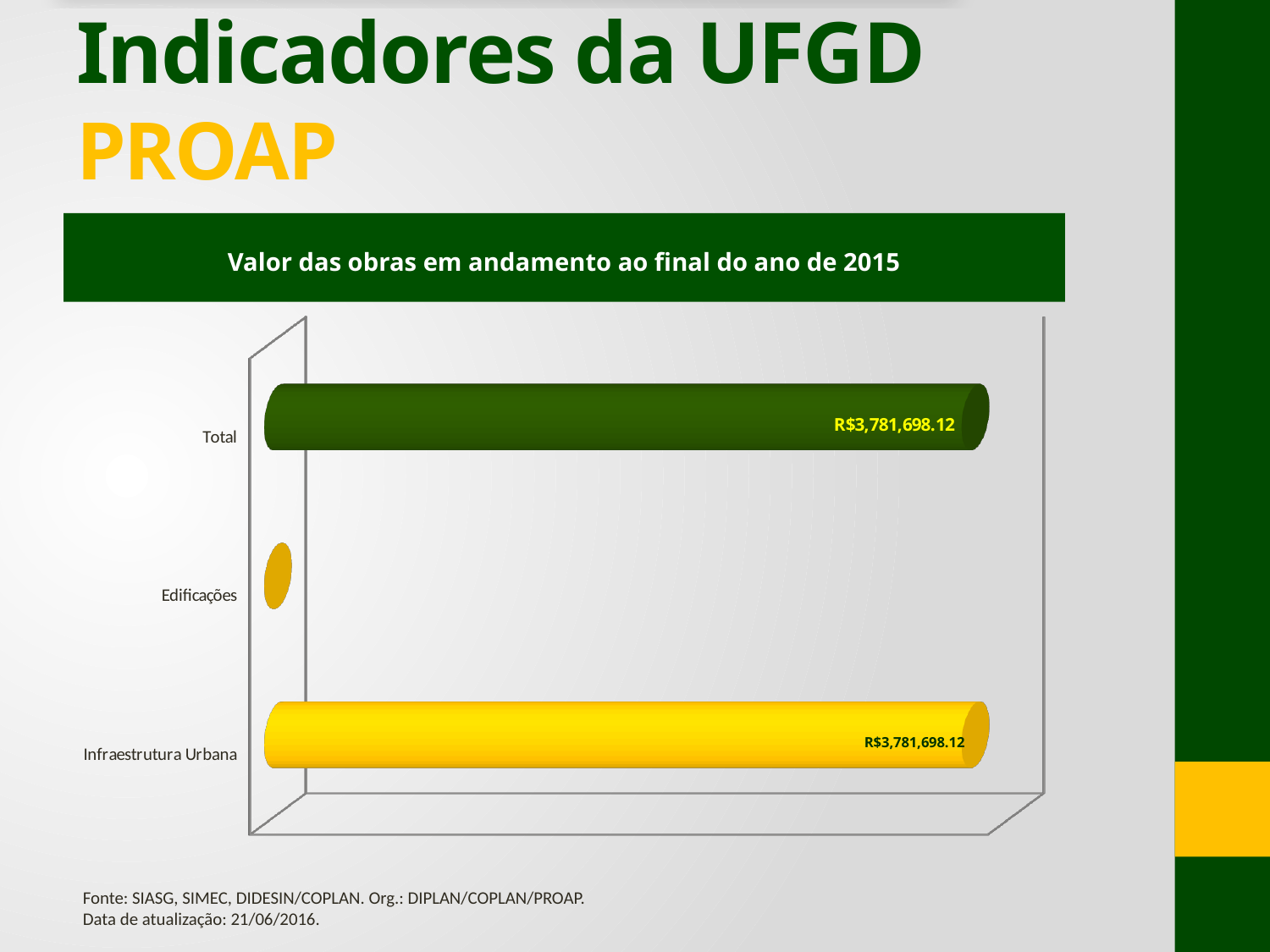
What is the value shown for Infraestrutura Urbana? R$3,781,698.12 What is the value shown for Total? R$3,781,698.12 Which category's bar is shown in dark green? Total Which is larger, the value for Total or the value for Edificações? Total What is the title of the chart? Valor das obras em andamento ao final do ano de 2015 Which is larger, the value for Infraestrutura Urbana or the value for Edificações? Infraestrutura Urbana What is the difference between the value for Total and the value for Infraestrutura Urbana? R$0.00 How many categories are shown on the chart? 3 Which category has the lowest value? Edificações What kind of chart is shown on the slide? Bar chart